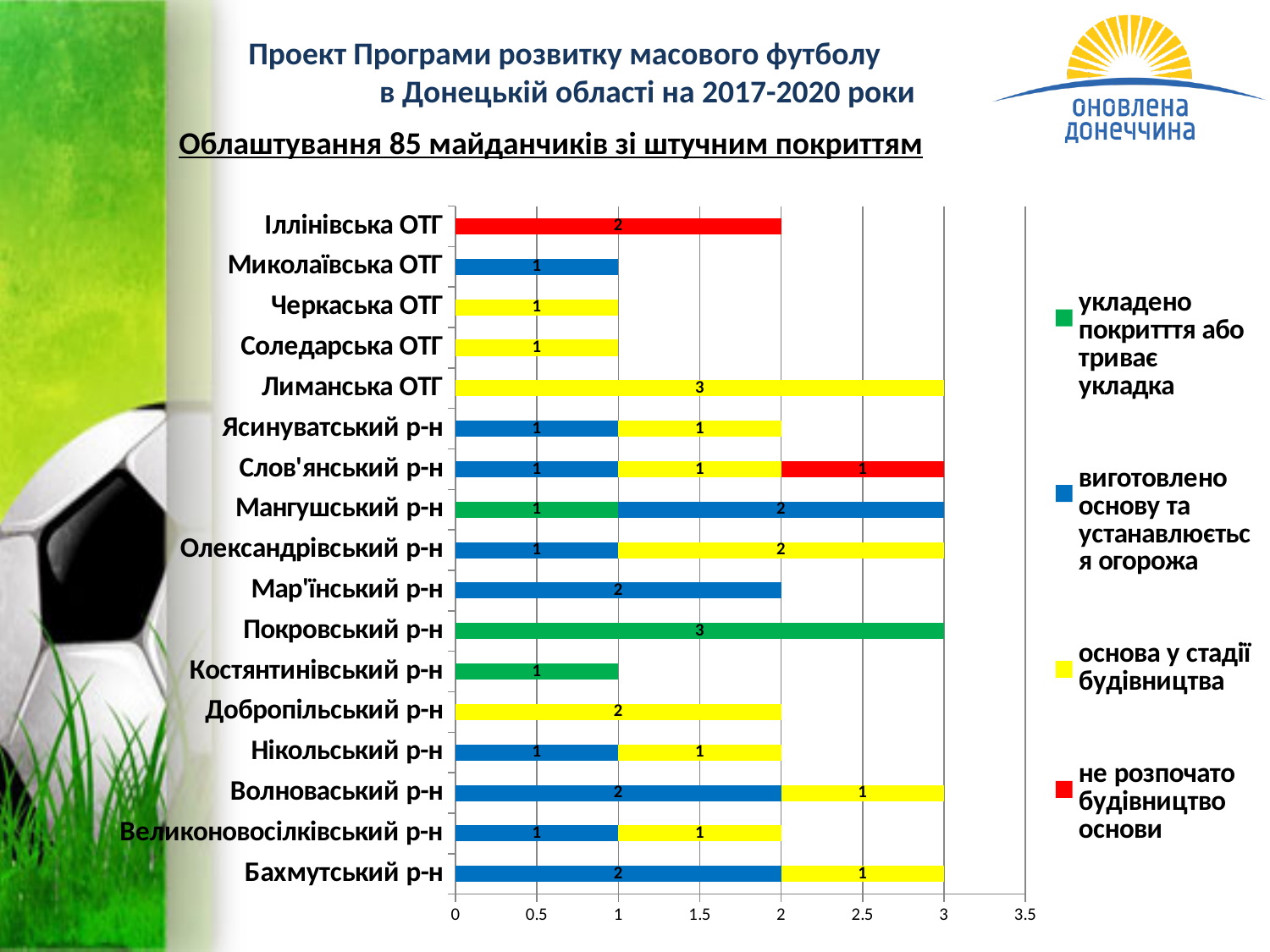
What is the value of the yellow segment (основа у стадії будівництва) for Лиманська ОТГ? 3 What is the total of the stacked bar for Слов'янський р-н? 3 Which legend entry is shown in red? не розпочато будівництво основи What is the value of the blue segment for Мангушський р-н? 2 What is the value of the green segment (укладено покриття або триває укладка) for Покровський р-н? 3 What is the difference between the yellow segment for Олександрівський р-н and the yellow segment for Нікольський р-н? 1 How many categories (districts/communities) are listed on the vertical axis of the chart? 17 Which is larger: the blue segment for Мар'їнський р-н or the blue segment for Миколаївська ОТГ? Мар'їнський р-н What is the value of the red segment for Іллінівська ОТГ? 2 How many series does the chart legend list? 4 What is the total of the stacked bar for Бахмутський р-н? 3 What kind of chart is shown on the slide? stacked bar chart